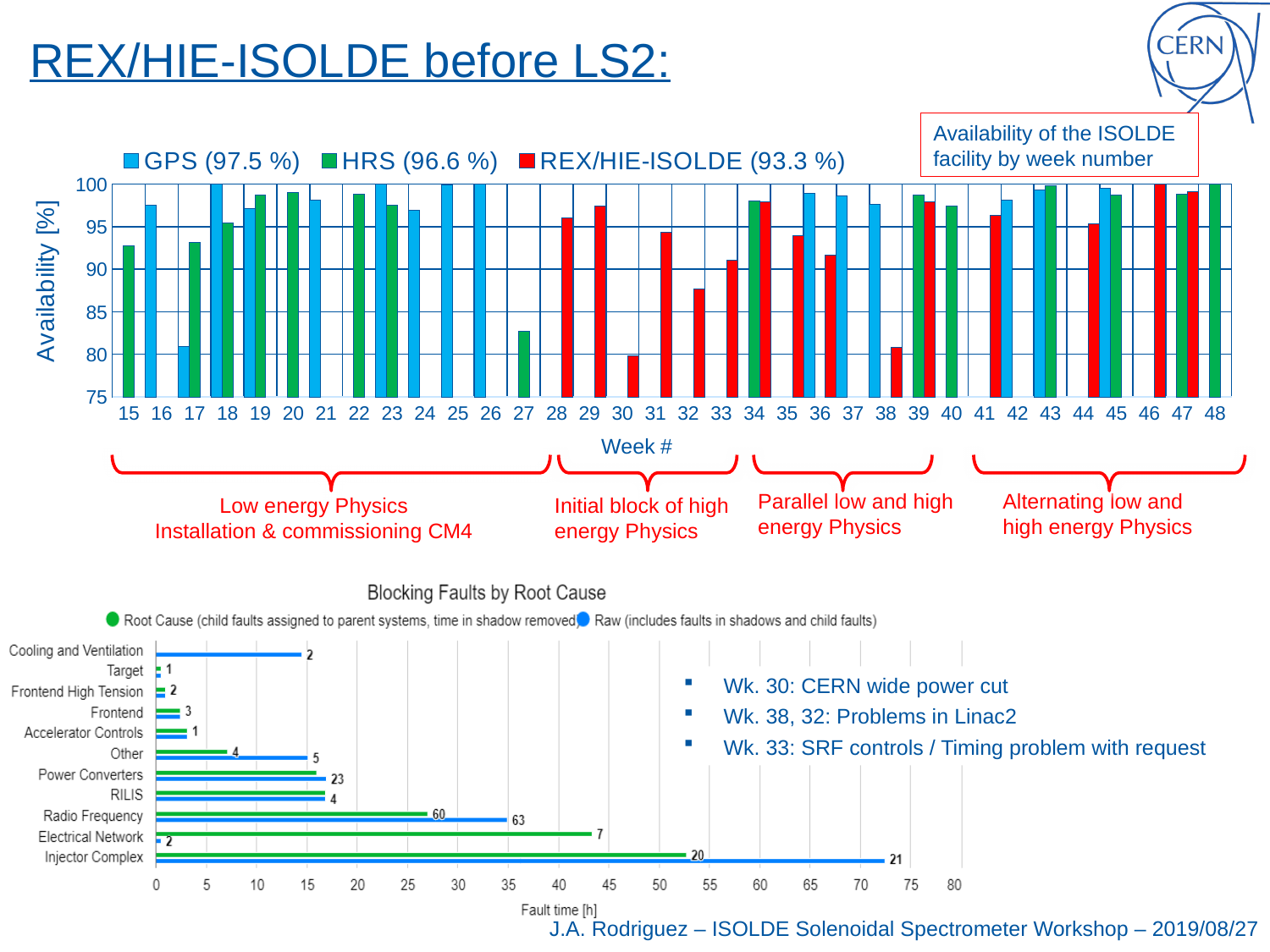
In the availability chart at the top, what overall availability is shown for GPS in the legend? 97.5 % What kind of chart is the 'Blocking Faults by Root Cause' chart at the bottom of the slide? bar chart In the availability chart at the top, is the HRS value for week 27 greater or less than 85? less In the 'Blocking Faults by Root Cause' chart, which category has the longest Raw (blue) bar? Injector Complex In the availability chart at the top, how many week numbers are shown on the x axis? 34 In the availability chart at the top, what overall availability is shown for REX/HIE-ISOLDE in the legend? 93.3 % In the availability chart at the top, is the GPS value for week 17 greater or less than 85? less In the availability chart at the top, how many series does the legend list? 3 In the availability chart at the top, which of the three series has the lowest overall availability according to the legend? REX/HIE-ISOLDE In the availability chart at the top, is the REX/HIE-ISOLDE value for week 32 greater or less than 90? less In the 'Blocking Faults by Root Cause' chart, how many root-cause categories are listed on the vertical axis? 11